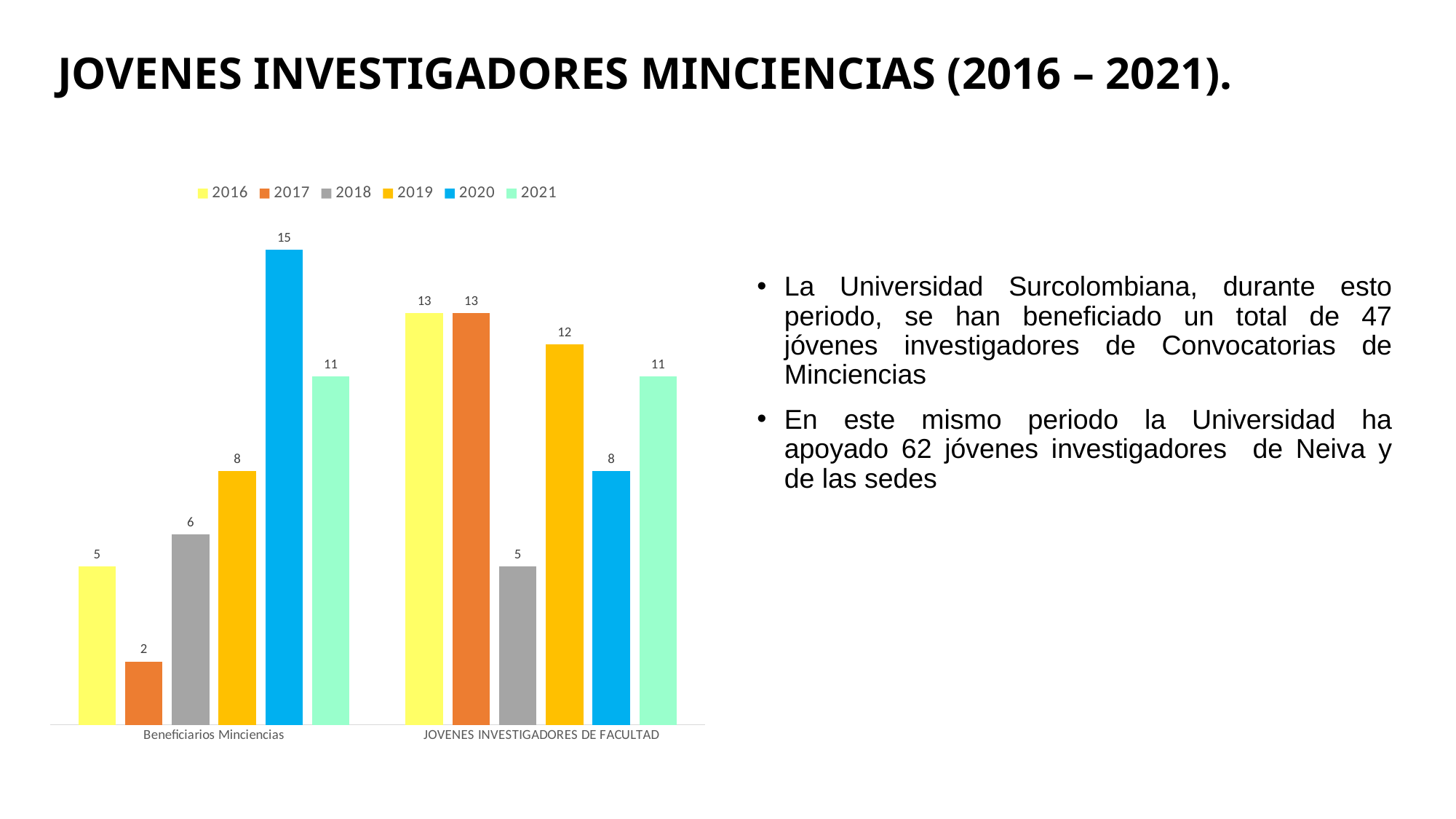
What is the value for 2018 in the Beneficiarios Minciencias category? 6 What kind of chart is shown on the slide? Bar chart What is the value for 2020 in the Beneficiarios Minciencias category? 15 Which year has the lowest value in the Beneficiarios Minciencias category? 2017 Which year has the highest value in the Beneficiarios Minciencias category? 2020 Which is larger: the 2019 value for Beneficiarios Minciencias or the 2019 value for JOVENES INVESTIGADORES DE FACULTAD? JOVENES INVESTIGADORES DE FACULTAD Which year has the lowest value in the JOVENES INVESTIGADORES DE FACULTAD category? 2018 How many categories are shown on the x axis? 2 How many series does the legend list? 6 What is the value for 2017 in the JOVENES INVESTIGADORES DE FACULTAD category? 13 What is the difference between the 2020 values for Beneficiarios Minciencias and JOVENES INVESTIGADORES DE FACULTAD? 7 Which colour represents the 2020 series in the legend? Blue